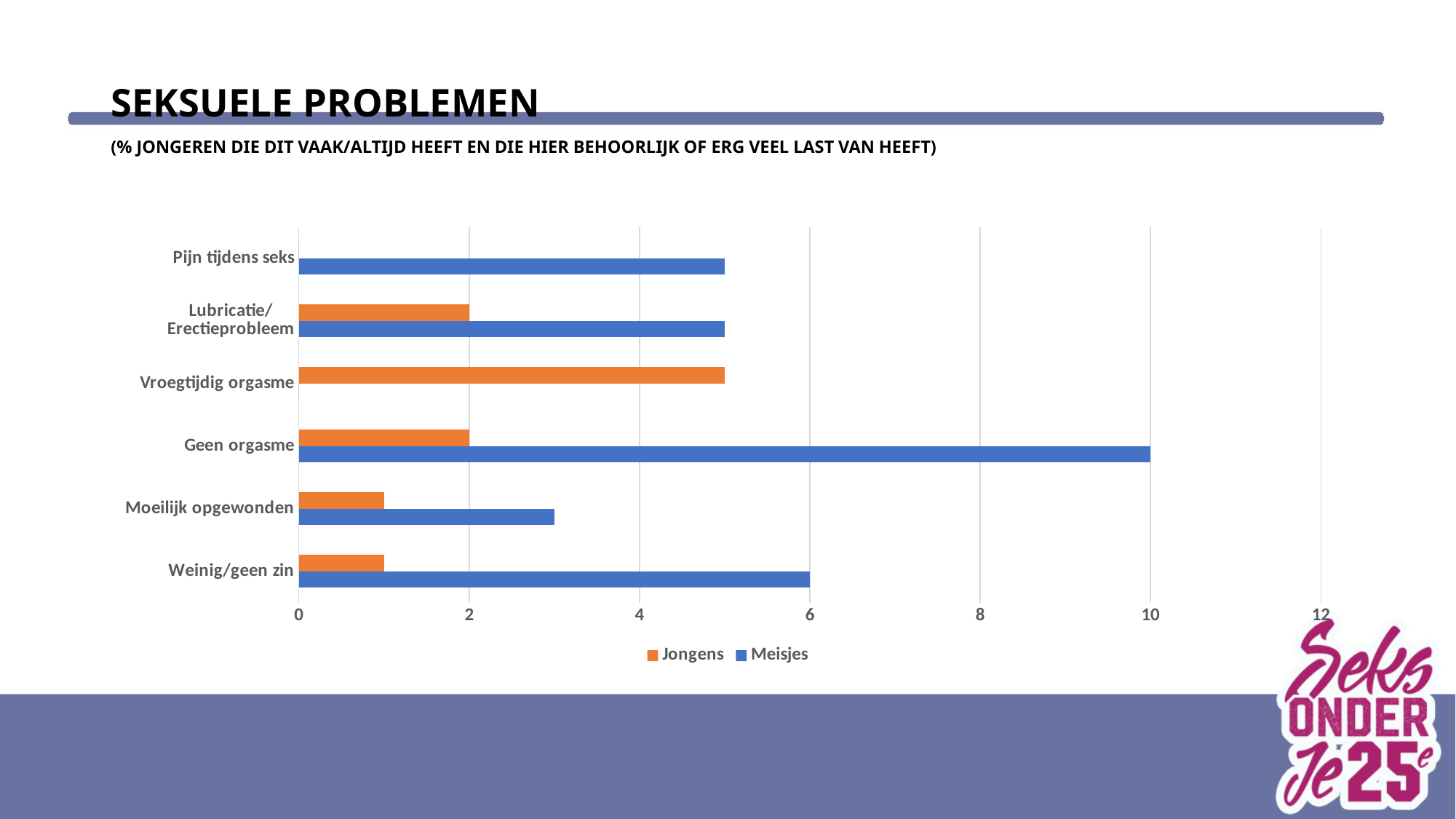
What is the difference between the Meisjes and Jongens values for Geen orgasme? 8 What is the value for Jongens for Lubricatie/Erectieprobleem? 2 Which category has the highest value for Meisjes? Geen orgasme How many categories are shown on the chart? 6 What kind of chart is shown on the slide? bar chart How many series does the legend list? 2 Is the value for Meisjes for Pijn tijdens seks greater or less than 4? greater Which category has the highest value for Jongens? Vroegtijdig orgasme What is the value for Meisjes for Geen orgasme? 10 Which series has the larger value for Weinig/geen zin, Jongens or Meisjes? Meisjes What is the value for Jongens for Geen orgasme? 2 What is the value for Meisjes for Weinig/geen zin? 6